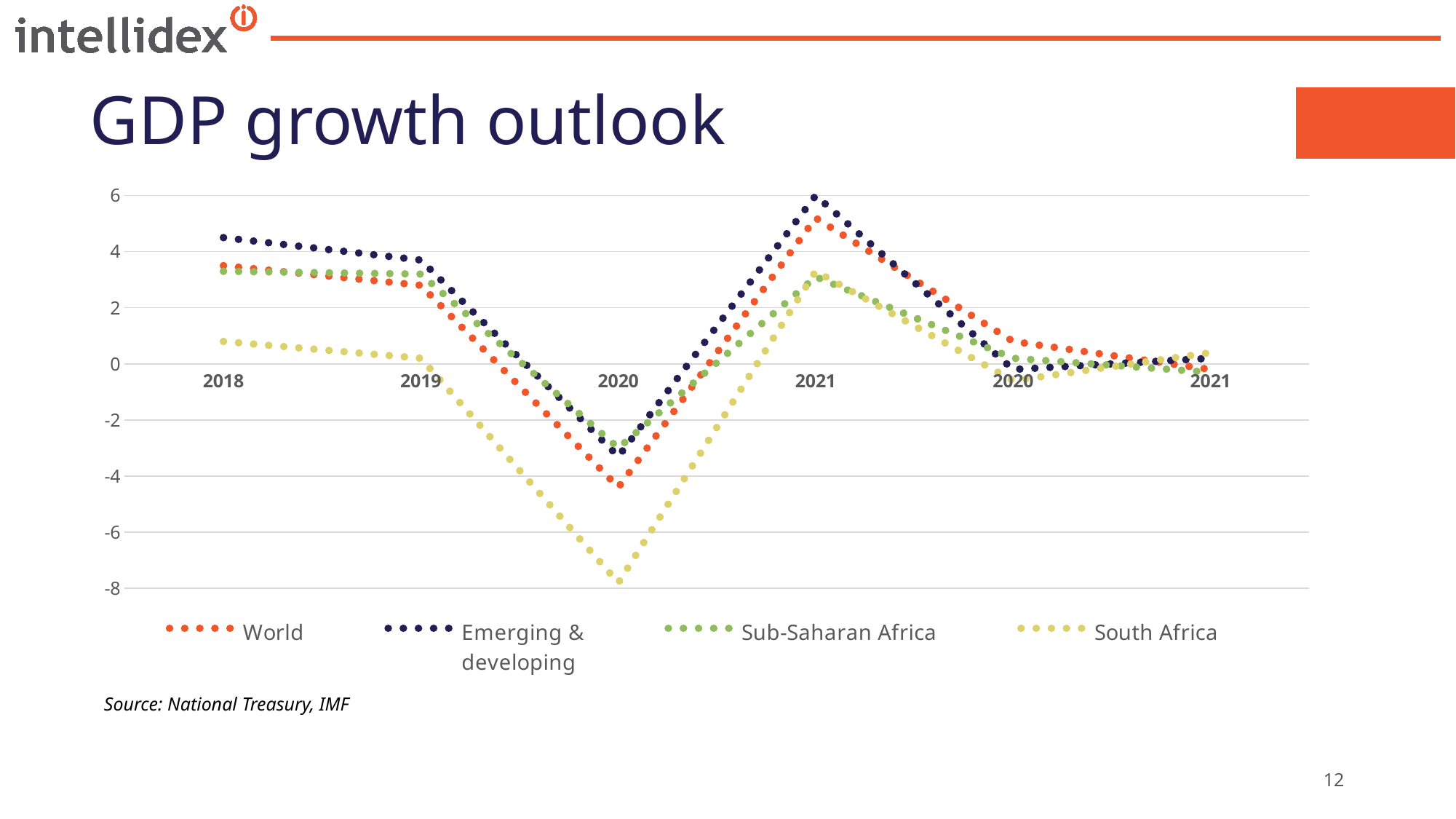
What source is cited below the chart? National Treasury, IMF How many points are labelled along the x axis? 6 At the first 2020 point, which is higher, World or South Africa? World Which series has the highest value at the first 2021 point? Emerging & developing What kind of chart is shown on the slide? Line chart Do the values for all series rise or fall from 2019 to the first 2020 point? Fall Which series has the lowest value at the first 2020 point? South Africa What is the title of the chart? GDP growth outlook How many series does the legend list? 4 Is the value for South Africa at the first 2020 point greater or less than -6? less Is the value for South Africa at 2018 greater or less than 2? less Is the value for Emerging & developing at 2018 greater or less than 4? greater